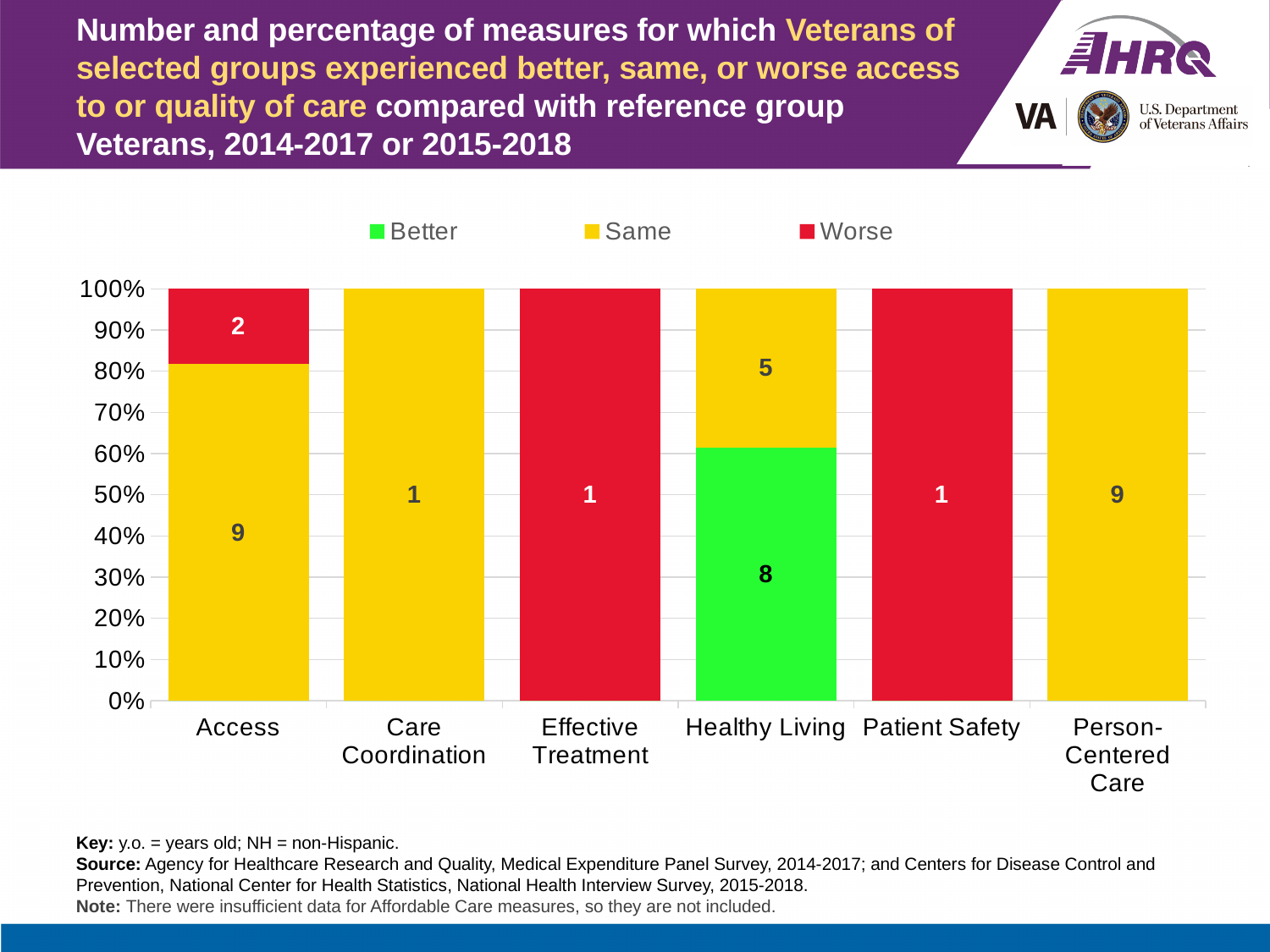
What is the total number of measures shown in the Healthy Living bar? 13 Is the "Better" share of the Healthy Living bar greater or less than 50%? greater How many measures are labeled "Better" for Healthy Living? 8 How many measures are labeled "Worse" for Access? 2 How many categories are shown on the x axis? 6 Which has more measures labeled "Same": Access or Care Coordination? Access How many measures are labeled "Same" for Person-Centered Care? 9 What is the difference between the number of "Better" and "Same" measures for Healthy Living? 3 How many measures are labeled "Same" for Access? 9 How many series does the legend list? 3 How many measures are labeled "Same" for Healthy Living? 5 What is the total number of measures shown in the Access bar? 11